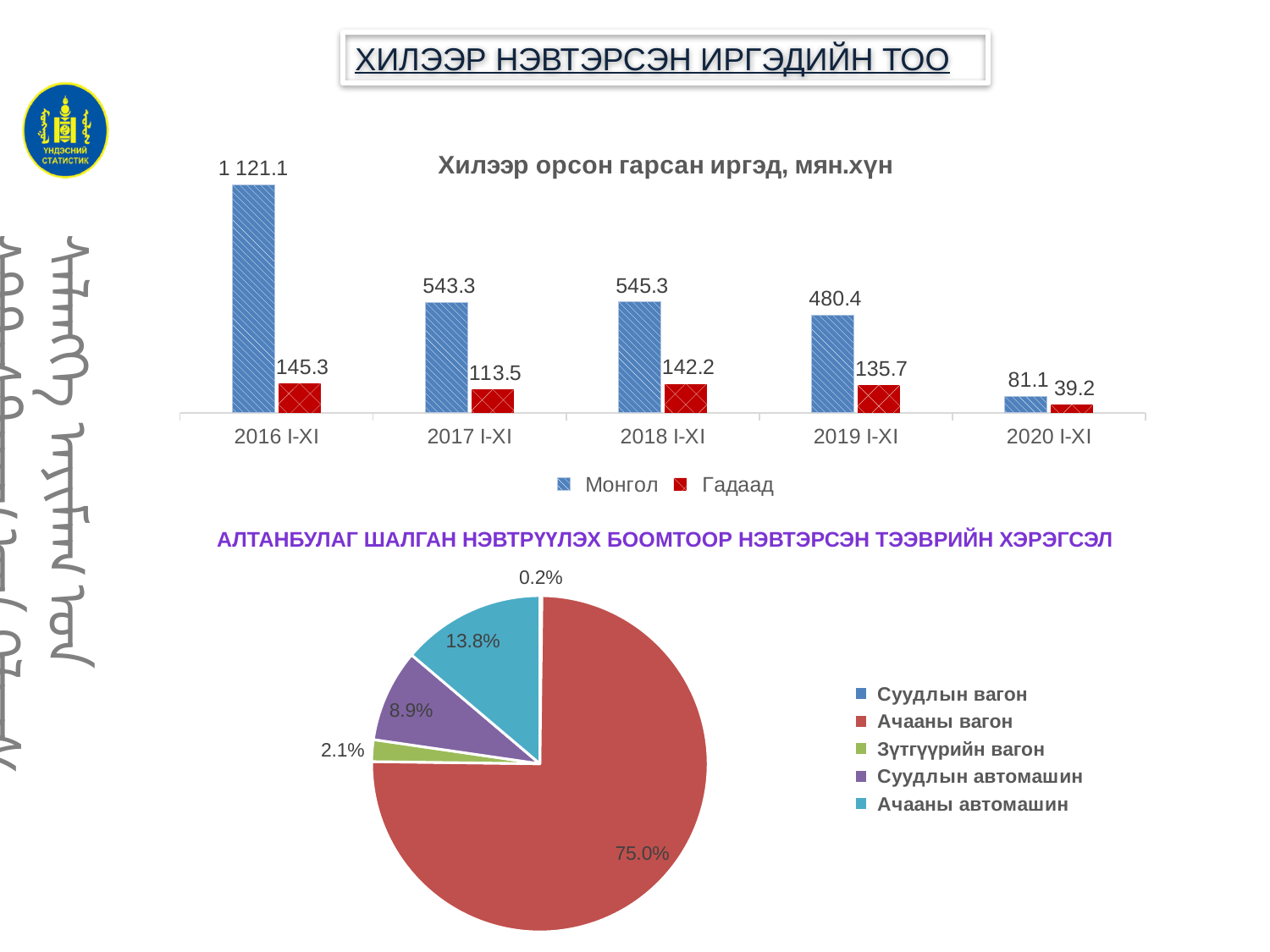
In the bar chart 'Хилээр орсон гарсан иргэд, мян.хүн', what is the value for Гадаад in 2019 I-XI? 135.7 In the bar chart 'Хилээр орсон гарсан иргэд, мян.хүн', which is larger: Гадаад in 2017 I-XI or Гадаад in 2018 I-XI? 2018 I-XI In the bar chart 'Хилээр орсон гарсан иргэд, мян.хүн', what is the value for Монгол in 2016 I-XI? 1 121.1 How many series does the legend of the bar chart 'Хилээр орсон гарсан иргэд, мян.хүн' list? 2 In the bar chart 'Хилээр орсон гарсан иргэд, мян.хүн', which period has the highest value for Гадаад? 2016 I-XI How many periods are shown on the x axis of the bar chart 'Хилээр орсон гарсан иргэд, мян.хүн'? 5 How many categories does the legend of the pie chart 'АЛТАНБУЛАГ ШАЛГАН НЭВТРҮҮЛЭХ БООМТООР НЭВТЭРСЭН ТЭЭВРИЙН ХЭРЭГСЭЛ' list? 5 In the pie chart 'АЛТАНБУЛАГ ШАЛГАН НЭВТРҮҮЛЭХ БООМТООР НЭВТЭРСЭН ТЭЭВРИЙН ХЭРЭГСЭЛ', which category has the smallest slice? Суудлын вагон In the bar chart 'Хилээр орсон гарсан иргэд, мян.хүн', which period has the lowest value for Монгол? 2020 I-XI What type of chart is the top chart 'Хилээр орсон гарсан иргэд, мян.хүн'? Bar chart In the bar chart 'Хилээр орсон гарсан иргэд, мян.хүн', what is the difference between the Монгол values for 2018 I-XI and 2019 I-XI? 64.9 In the pie chart 'АЛТАНБУЛАГ ШАЛГАН НЭВТРҮҮЛЭХ БООМТООР НЭВТЭРСЭН ТЭЭВРИЙН ХЭРЭГСЭЛ', what share does Ачааны вагон have? 75.0%